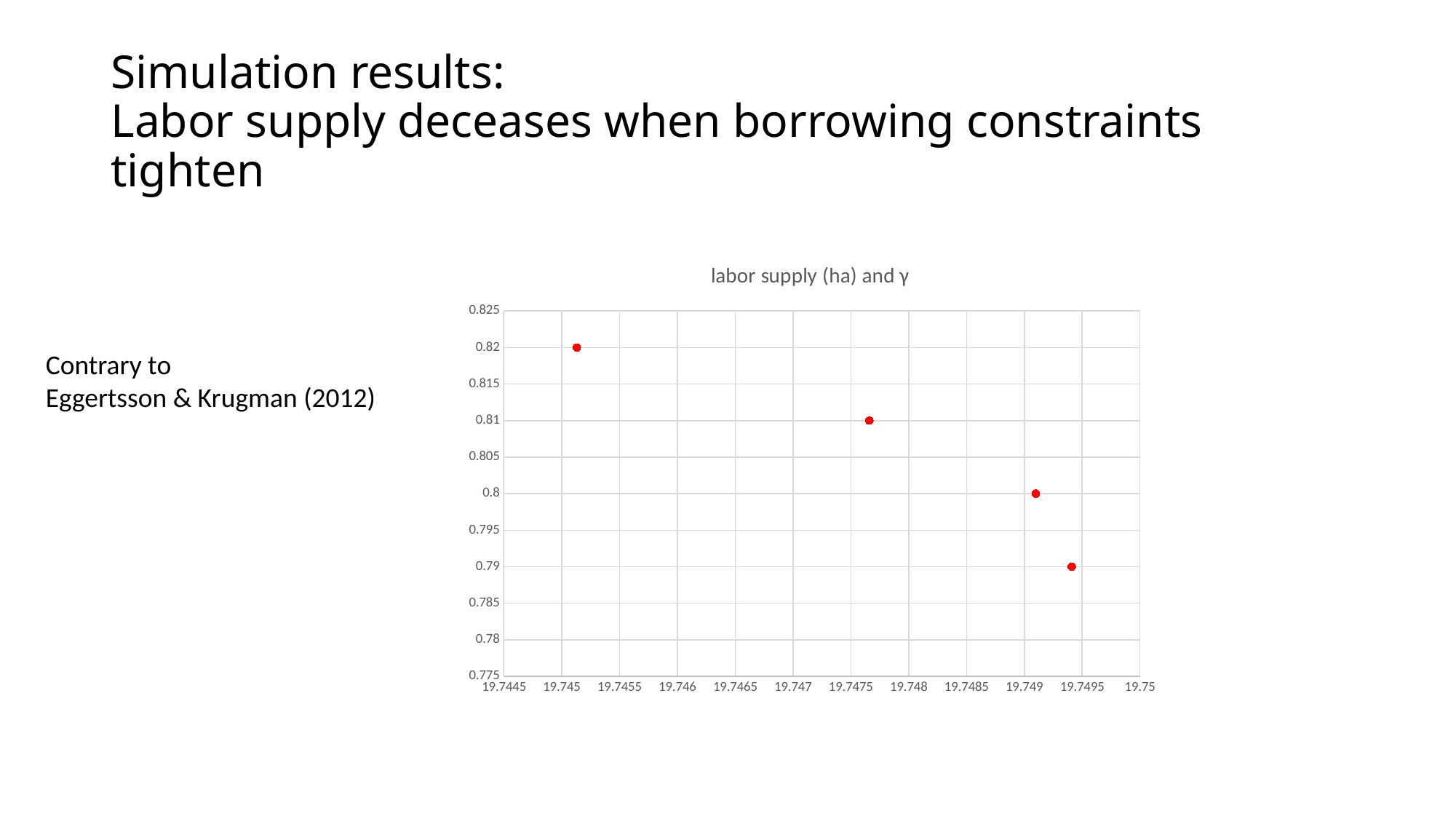
How many data points are plotted in the chart? 4 Which point has the larger y-axis value, the leftmost point or the rightmost point? the leftmost point What is the highest y-axis value reached by any point in the chart? 0.82 What is the y-axis value of the rightmost point in the chart? 0.79 What is the difference between the y-axis values of the leftmost and rightmost points? 0.03 What is the title of the chart? labor supply (ha) and γ Do the plotted values rise or fall as you move from left to right along the x axis? fall What is the lowest y-axis value reached by any point in the chart? 0.79 What kind of chart is shown on the slide? scatter chart What is the y-axis value of the leftmost point in the chart? 0.82 Is the x-axis value of the leftmost point greater or less than 19.746? less What is the y-axis value of the second point from the left? 0.81